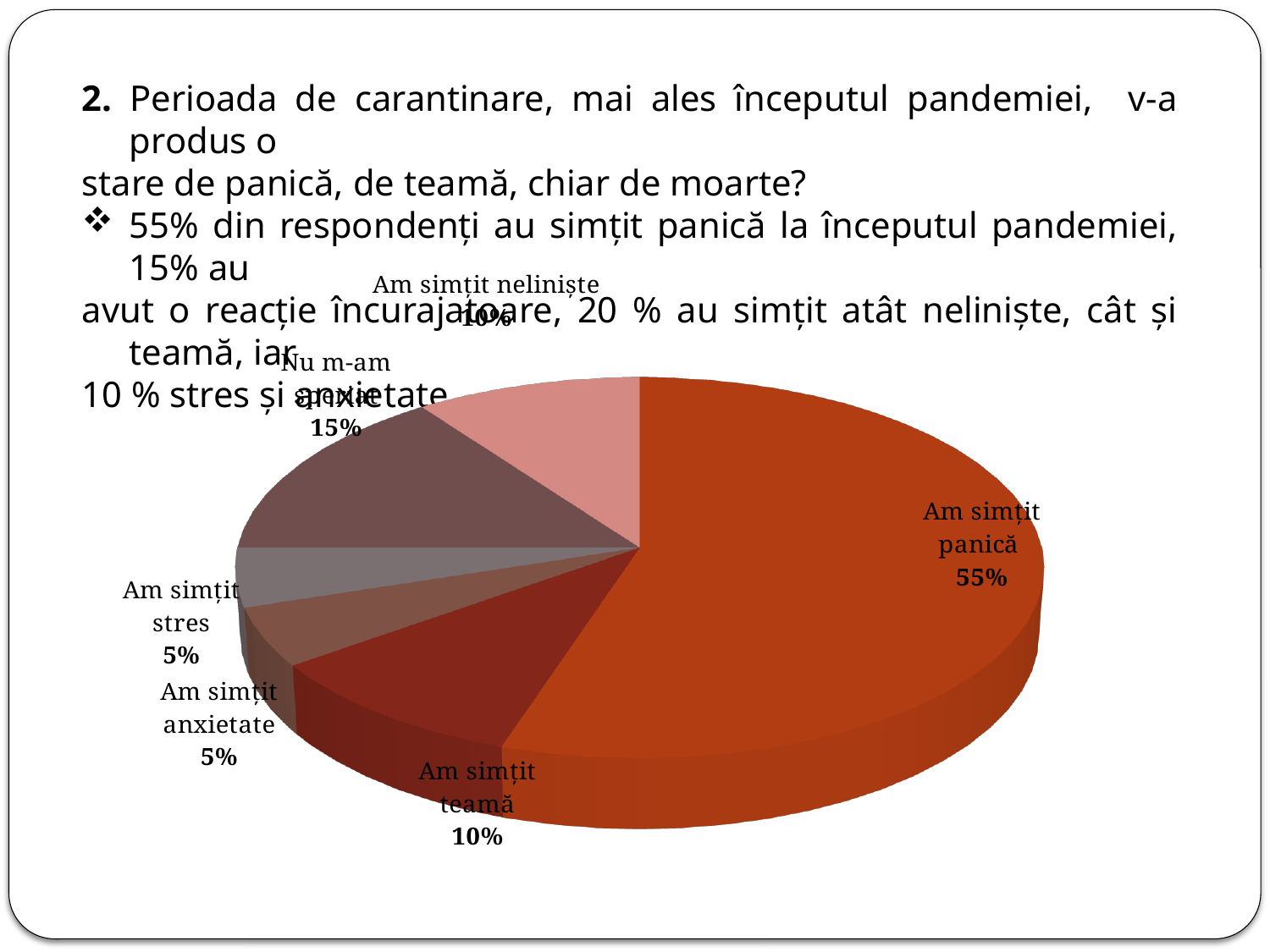
What value is shown for 'Am simțit anxietate'? 5% How many slices does the pie chart have? 6 Which category has the largest slice of the pie? Am simțit panică What kind of chart is shown on the slide? Pie chart What percentage is shown for the 'Am simțit teamă' slice? 10% What is the difference between the 'Am simțit panică' and 'Am simțit teamă' percentages? 45% What value is shown for 'Am simțit stres'? 5% What percentage of respondents is shown for 'Am simțit panică'? 55% What percentage is shown for the slice whose label begins 'Nu m-am'? 15% What share of the pie does 'Am simțit panică' represent? 55% What percentage is shown for 'Am simțit neliniște'? 10% Which is larger, the 'Am simțit teamă' slice or the 'Am simțit stres' slice? Am simțit teamă